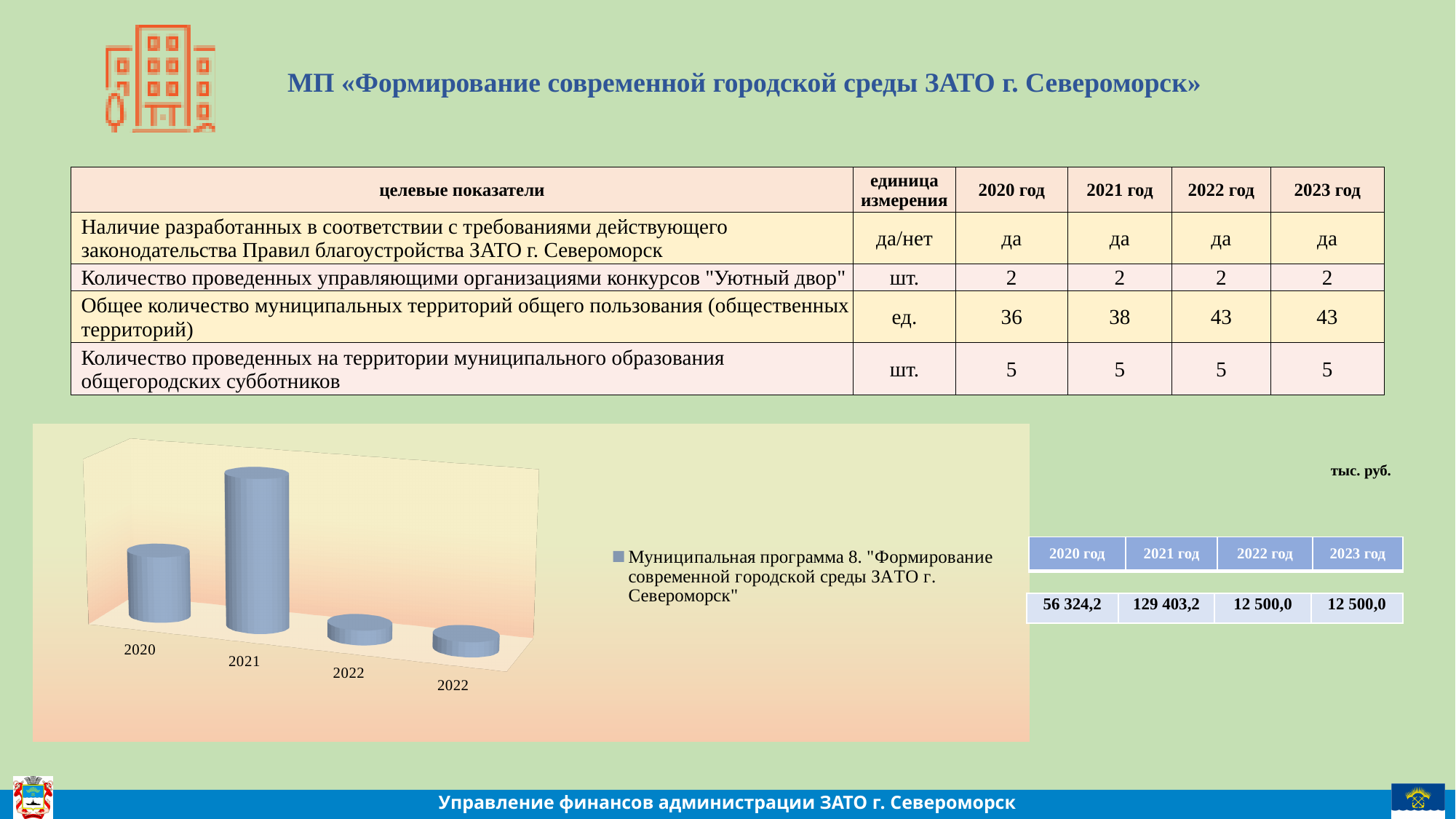
Which bar is taller in the chart, 2020 or 2021? 2021 What unit of measurement is indicated above the data table next to the chart? тыс. руб. Which bar is taller in the chart, 2020 or the first 2022 bar? 2020 Which year has the tallest bar in the chart? 2021 According to the data table next to the chart, what is the value for 2020 год? 56 324,2 How many bars does the chart at the bottom of the slide show? 4 According to the data table next to the chart, what is the value for 2021 год? 129 403,2 According to the data table next to the chart, what is the value for 2023 год? 12 500,0 How many series does the chart's legend list? 1 Does the value fall or rise from 2021 to 2022 in the chart? fall What kind of chart is shown at the bottom of the slide? bar chart Using the data table next to the chart, what is the difference between the 2021 год and 2020 год values? 73 079,0